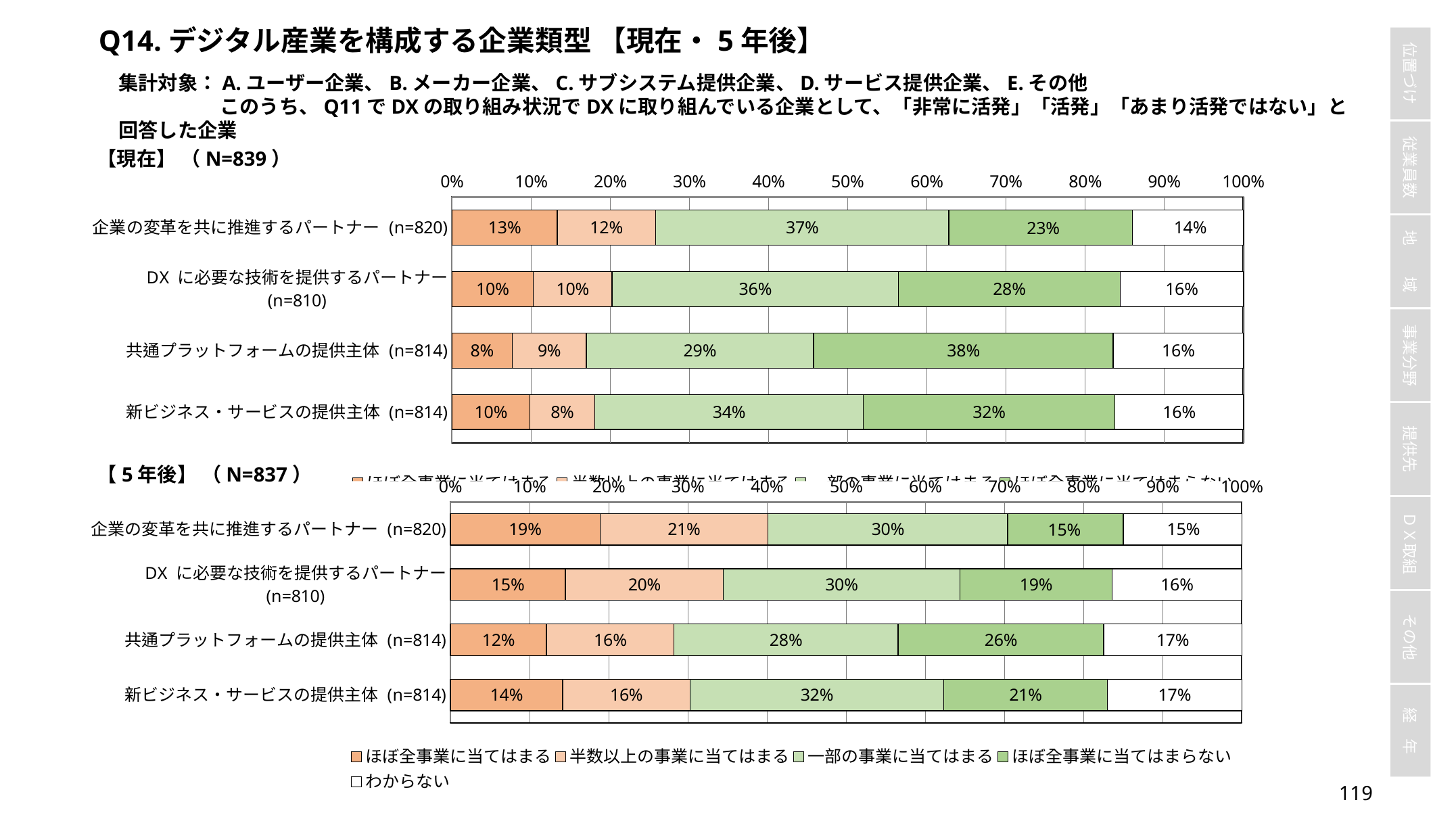
How many series does the legend at the bottom of the slide list? 5 What type of chart is the 【現在】 chart? Stacked bar chart In the 【5年後】 chart, which category has the lowest value for ほぼ全事業に当てはまる? 共通プラットフォームの提供主体 In the 【5年後】 chart, what is the combined share of ほぼ全事業に当てはまる and 半数以上の事業に当てはまる for DX に必要な技術を提供するパートナー? 35% In the 【現在】 chart, what percentage of respondents answered ほぼ全事業に当てはまる for 企業の変革を共に推進するパートナー? 13% How many categories are shown in the 【5年後】 chart? 4 In the 【現在】 chart, which is larger for DX に必要な技術を提供するパートナー: 一部の事業に当てはまる or ほぼ全事業に当てはまらない? 一部の事業に当てはまる In the 【現在】 chart, what is the value of ほぼ全事業に当てはまらない for 共通プラットフォームの提供主体? 38% In the 【現在】 chart, which category has the highest value for ほぼ全事業に当てはまらない? 共通プラットフォームの提供主体 What is the difference between the ほぼ全事業に当てはまる value for 企業の変革を共に推進するパートナー in the 【5年後】 chart and in the 【現在】 chart? 6 percentage points In the 【5年後】 chart, what is the value of 半数以上の事業に当てはまる for 企業の変革を共に推進するパートナー? 21% In the 【5年後】 chart, what is the value of わからない for 新ビジネス・サービスの提供主体? 17%